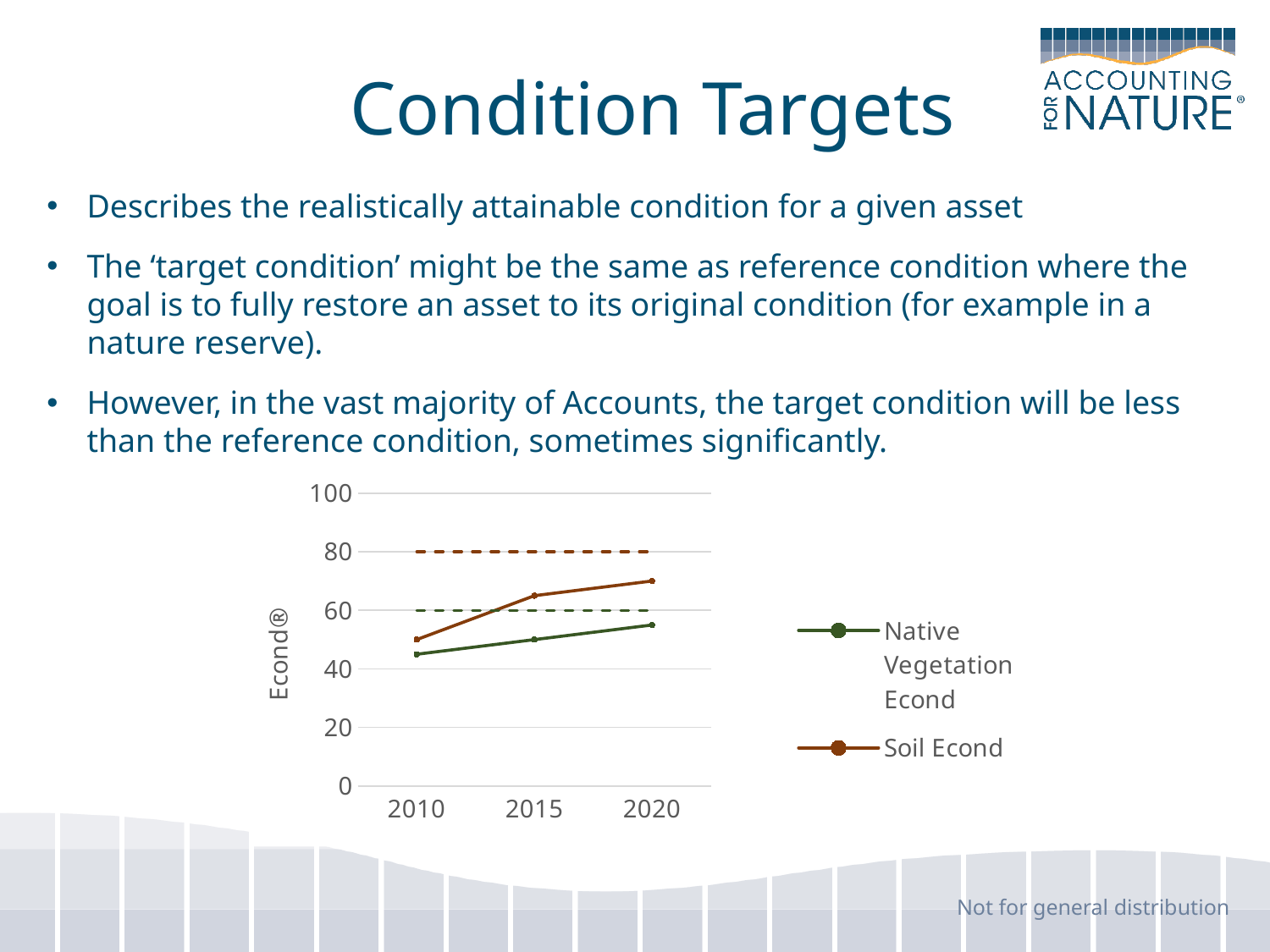
Does the Soil Econd line rise or fall from 2010 to 2020? rise Does the Native Vegetation Econd line rise or fall from 2010 to 2020? rise How many series does the chart legend list? 2 Which series is plotted in brown according to the legend? Soil Econd Is the value for Soil Econd in 2015 greater or less than 60? greater What is the label on the y axis of the chart? Econd® In 2020, which series has the higher value, Soil Econd or Native Vegetation Econd? Soil Econd At which y-axis value does the brown dashed horizontal line sit? 80 Is the value for Native Vegetation Econd in 2010 greater or less than 60? less Is the value for Soil Econd in 2020 greater or less than 80? less How many years are shown on the x axis of the chart? 3 What kind of chart is shown on the slide? line chart